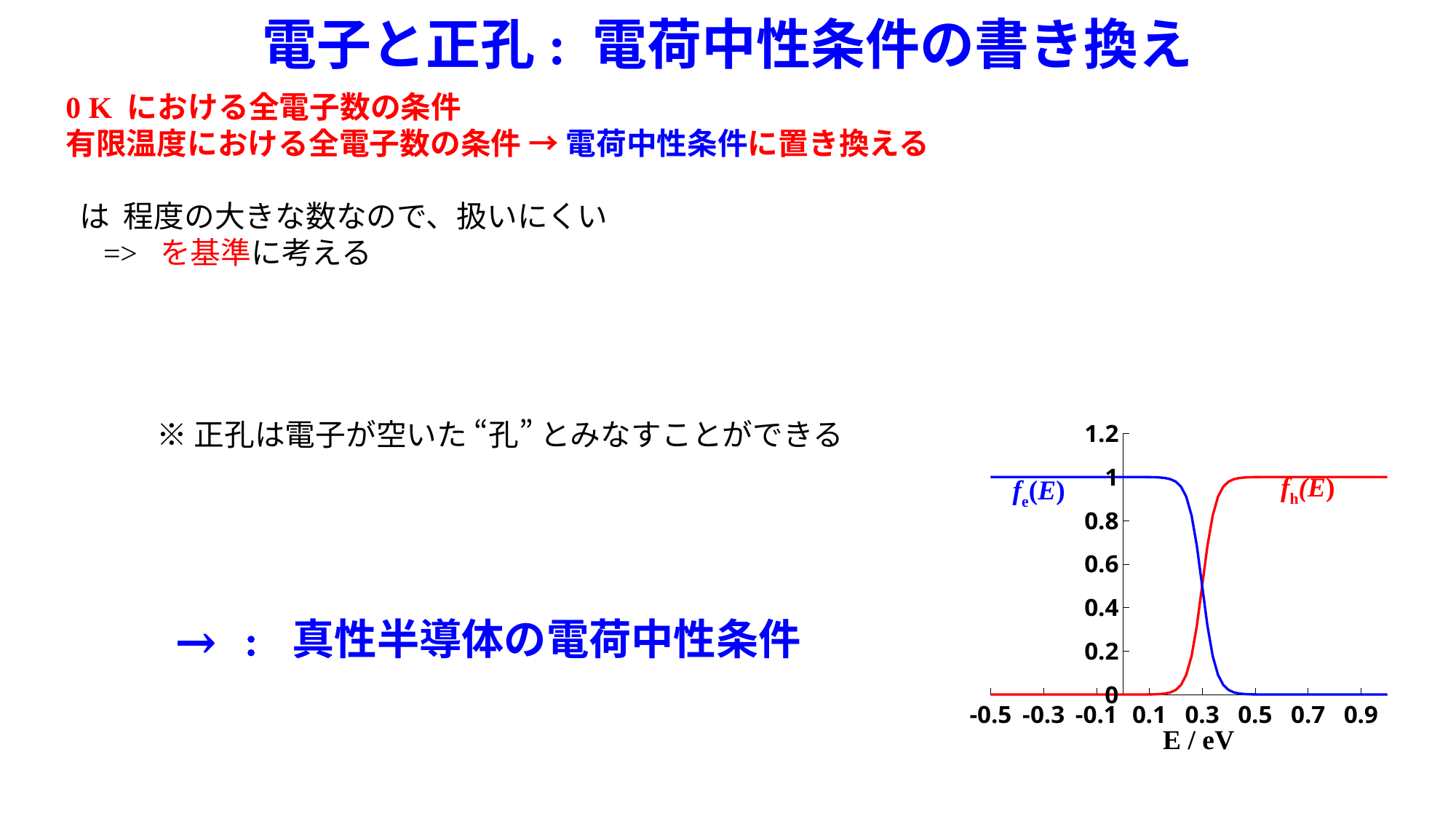
How many curves are plotted on the chart? 2 Does the blue curve f_e(E) rise or fall as E increases? fall At E = 0.9 eV, which curve has the larger value, f_e(E) or f_h(E)? f_h(E) Does the red curve f_h(E) rise or fall as E increases? rise At E = -0.3 eV, which curve has the larger value, f_e(E) or f_h(E)? f_e(E) Is the value of f_e(E) at E = -0.5 eV greater or less than 0.5? greater Is the value of f_e(E) at E = 0.9 eV greater or less than 0.2? less What kind of chart is shown on the slide? line chart Is the value of f_h(E) at E = 0.9 eV greater or less than 0.8? greater What is the label of the x axis of the chart? E / eV What colour is the curve labelled f_h(E)? red